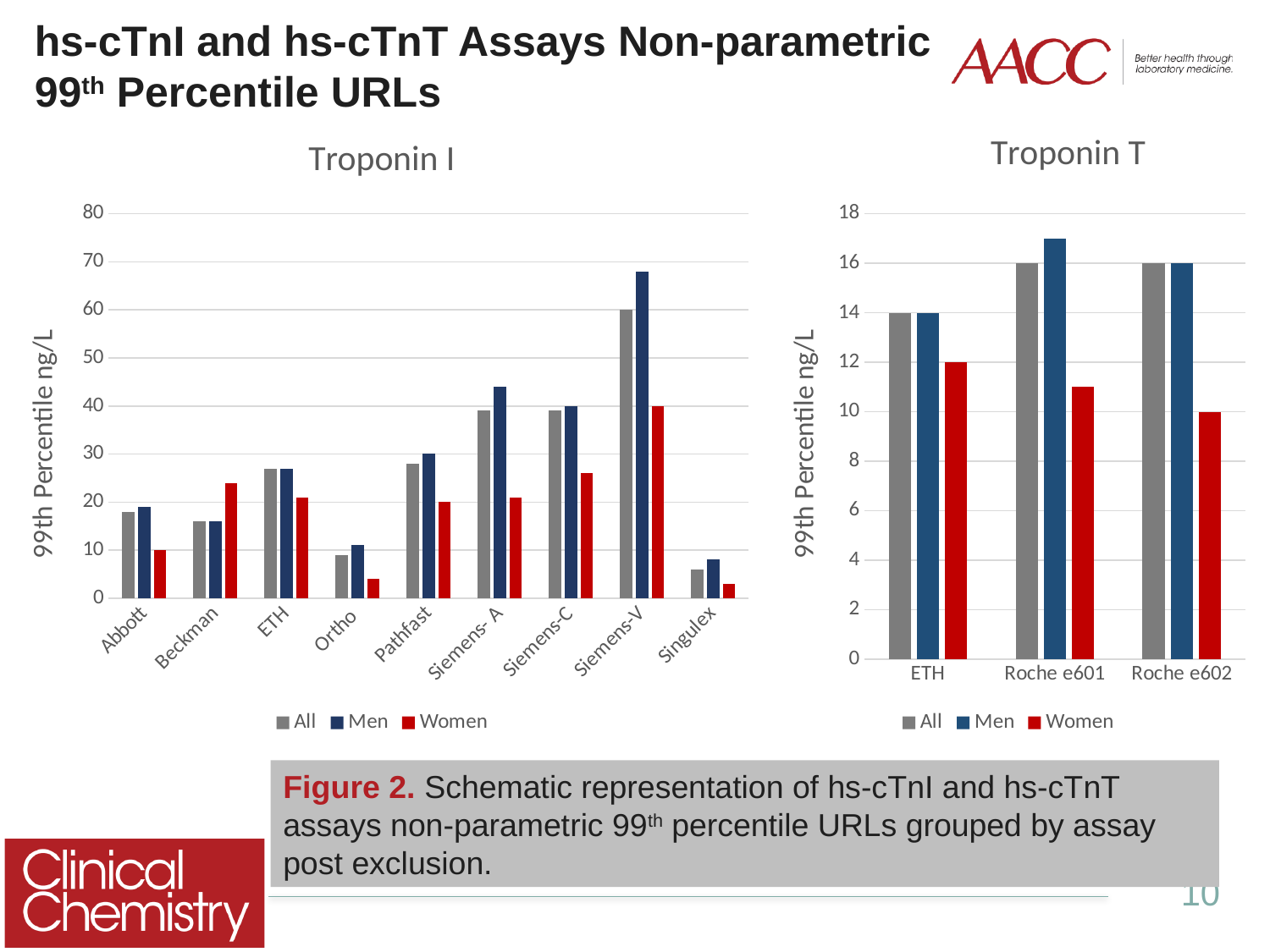
How many assays are shown on the x axis of the Troponin I chart? 9 How many series does the legend of the Troponin T chart list? 3 What kind of chart is the Troponin I chart? bar chart In the Troponin I chart, is the value for Women at Ortho greater or less than 10? less In the Troponin I chart, is the value for Men at Siemens-A greater or less than 40? greater In the Troponin T chart, which is larger at Roche e601, the value for Men or the value for Women? Men In the Troponin I chart, which assay has the lowest value for Women? Singulex In the Troponin T chart, what is the value for All at ETH? 14 What is the y-axis title of the Troponin T chart? 99th Percentile ng/L In the Troponin I chart, which assay has the highest value for Men? Siemens-V In the Troponin T chart, which assay has the highest value for Men? Roche e601 In the Troponin T chart, what is the value for Women at Roche e602? 10